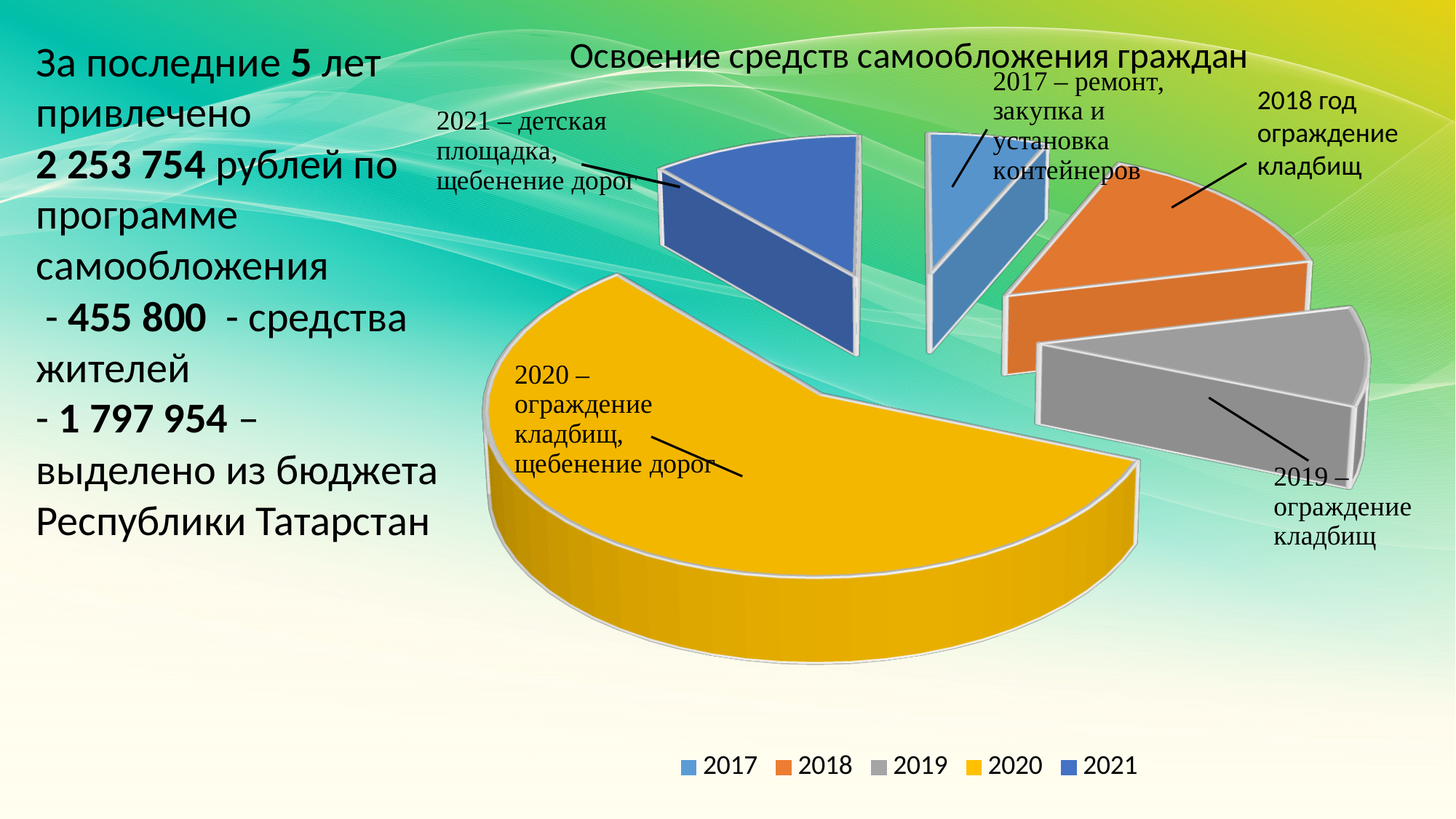
How many slices does the pie chart have? 5 Which slice is larger, 2017 or 2018? 2018 Which year's slice is labelled "ограждение кладбищ, щебенение дорог"? 2020 How many entries does the chart legend list? 5 Which year has the smallest slice of the pie? 2017 Which year's slice is labelled "ремонт, закупка и установка контейнеров"? 2017 What colour is the slice for 2020? yellow What is the title of the chart? Освоение средств самообложения граждан What kind of chart is shown on the slide? pie chart Which slice is larger, 2017 or 2021? 2021 Which year has the largest slice of the pie? 2020 Which slice is larger, 2020 or 2021? 2020